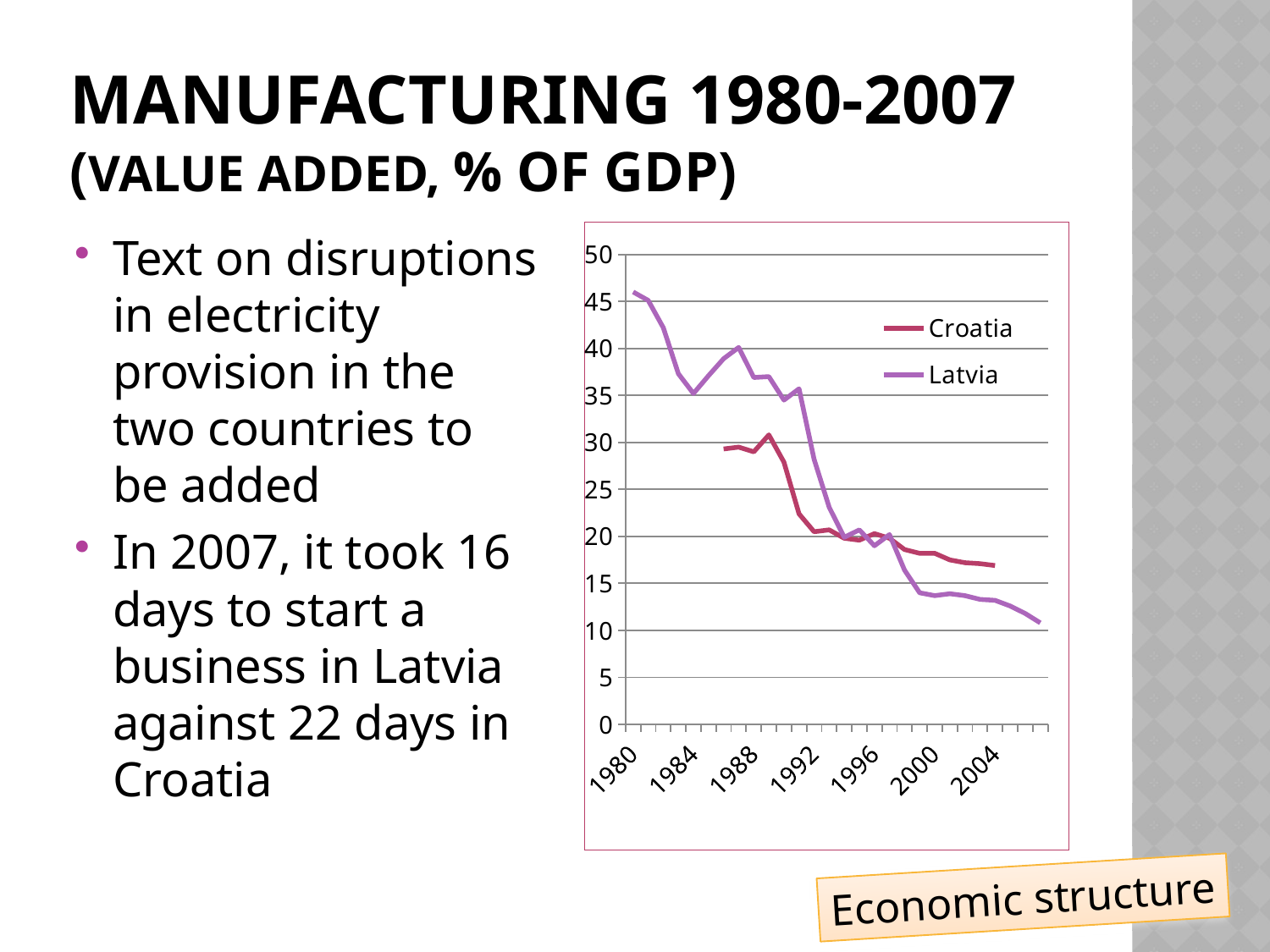
Which series has the larger value in 1988, Croatia or Latvia? Latvia Is the value for Latvia in 1980 greater or less than 40? greater Which series has the larger value in 2004, Croatia or Latvia? Croatia How many series does the chart legend list? 2 Which two countries are shown in the chart legend? Croatia and Latvia What kind of chart is shown on the slide? line chart Do the values for Croatia rise or fall over the period shown? fall What colour is the Latvia line in the chart? purple Is the value for Latvia in 2004 greater or less than 15? less Is the value for Croatia in 1988 greater or less than 25? greater How many year labels are shown on the x axis? 7 Do the values for Latvia rise or fall from 1980 to the end of the series? fall